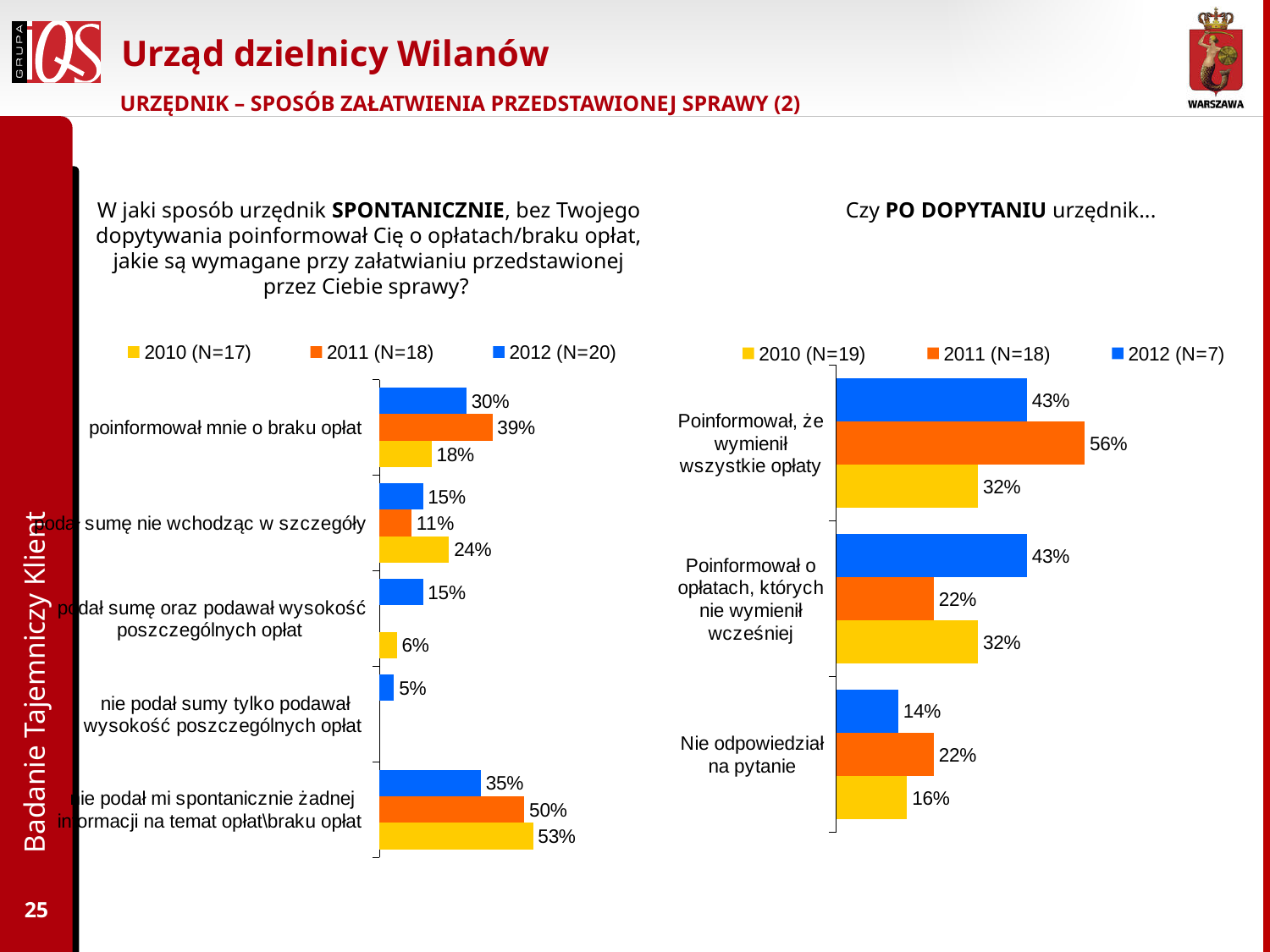
In the left chart, how many series does the legend list? 3 In the right chart, what is the 2012 value for 'Nie odpowiedział na pytanie'? 14% In the right chart, what is the difference between the 2010 and 2011 values for 'Nie odpowiedział na pytanie'? 6% What type of chart is the right chart? Bar chart In the right chart, what sample size (N) is given for 2012 in the legend? N=7 In the left chart, what is the 2010 value for 'nie podał mi spontanicznie żadnej informacji na temat opłat\braku opłat'? 53% In the left chart, how many categories are shown? 5 In the left chart, which series has the highest value for 'podał sumę nie wchodząc w szczegóły'? 2010 (N=17) In the left chart, what is the difference between the 2011 and 2012 values for 'nie podał mi spontanicznie żadnej informacji na temat opłat\braku opłat'? 15% In the right chart, which is larger for 'Poinformował o opłatach, których nie wymienił wcześniej': the 2012 value or the 2011 value? 2012 (43%) In the left chart, what is the 2011 value for 'poinformował mnie o braku opłat'? 39% In the right chart, what is the 2011 value for 'Poinformował, że wymienił wszystkie opłaty'? 56%